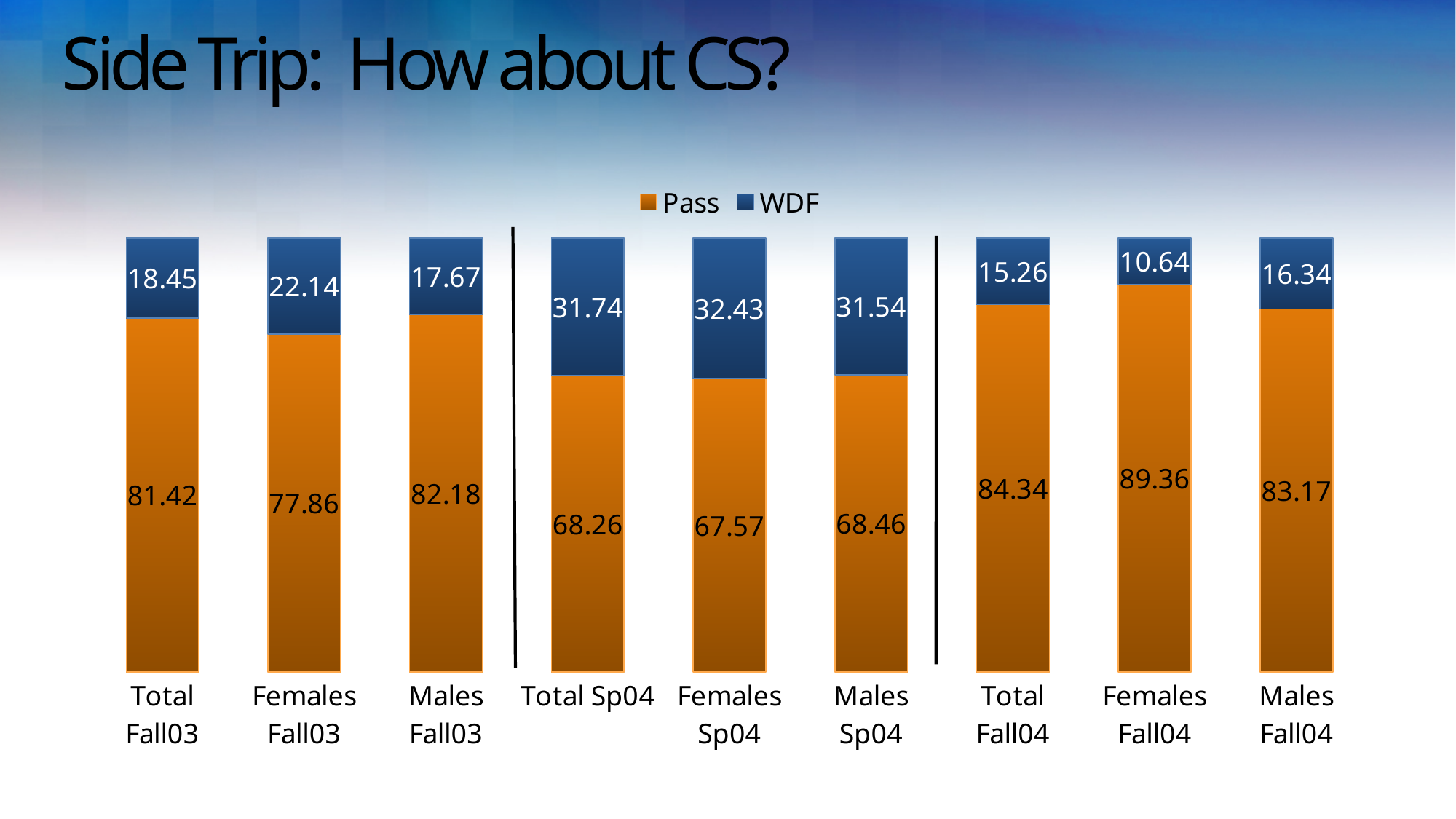
What is the difference between the Pass values for Males Fall03 and Females Fall03? 4.32 What is the Pass value for Males Fall04? 83.17 What kind of chart is shown on the slide? Stacked bar chart How many series does the legend list? 2 Which category has the lowest WDF value? Females Fall04 What is the difference between the Pass value for Females Fall04 and the Pass value for Females Sp04? 21.79 What is the WDF value for Females Sp04? 32.43 Which is larger, the WDF value for Total Sp04 or the WDF value for Total Fall04? Total Sp04 Which category has the lowest Pass value? Females Sp04 How many categories are shown on the x axis? 9 What is the Pass value for Total Fall03? 81.42 Which category has the highest Pass value? Females Fall04